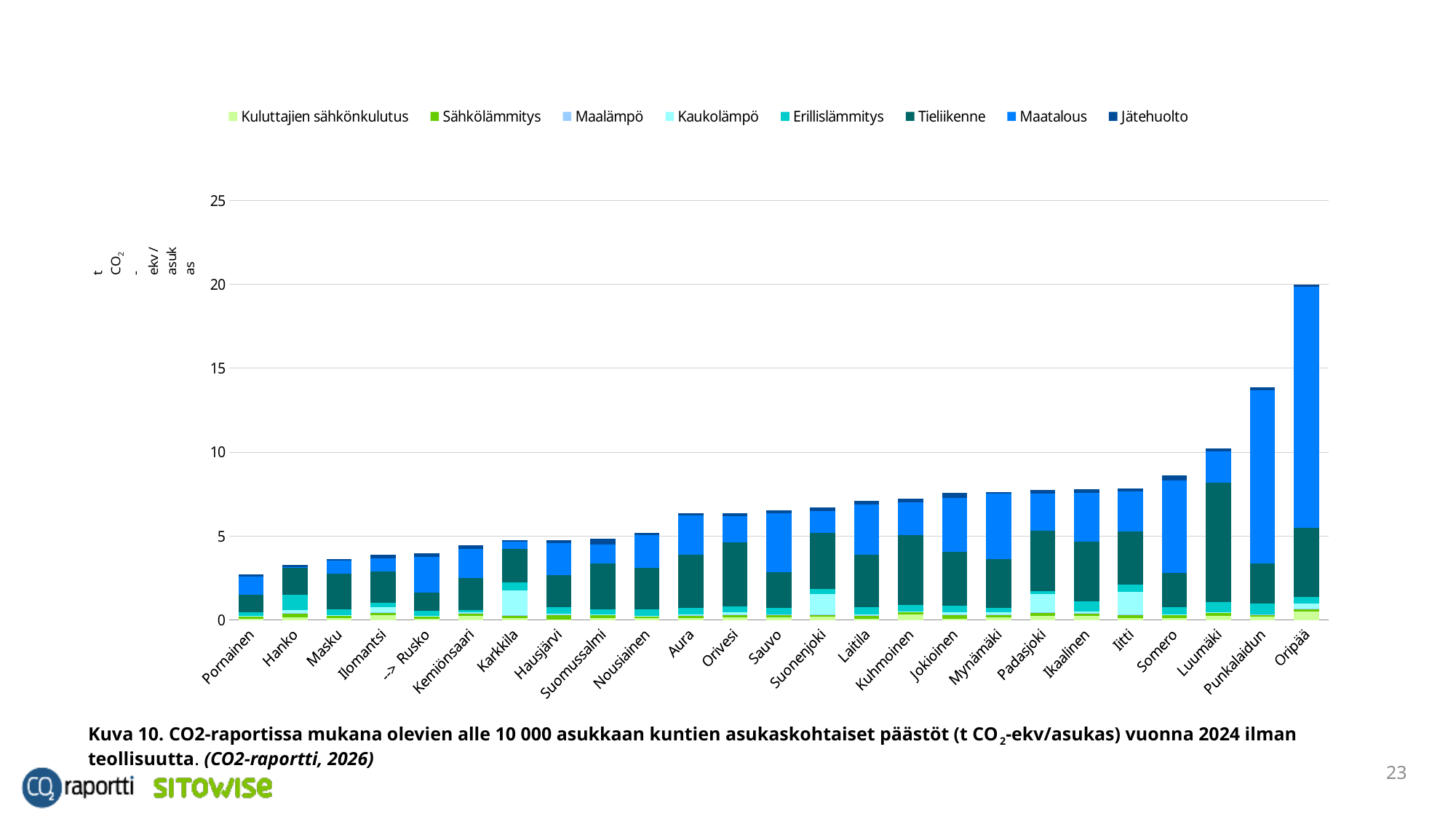
Is the total value for Punkalaidun greater or less than 15? less How many series does the legend list? 8 Is the total value for Somero greater or less than 10? less Is the total value for Pornainen greater or less than 5? less What kind of chart is shown on the slide? stacked bar chart Do the total bar heights rise or fall from left to right along the x axis? rise Which municipality has the highest total per-capita emissions? Oripää Which municipality has the lowest total per-capita emissions? Pornainen Which series is listed last in the legend? Jätehuolto Which has a larger total, Oripää or Punkalaidun? Oripää How many municipalities (categories) are shown on the x axis? 25